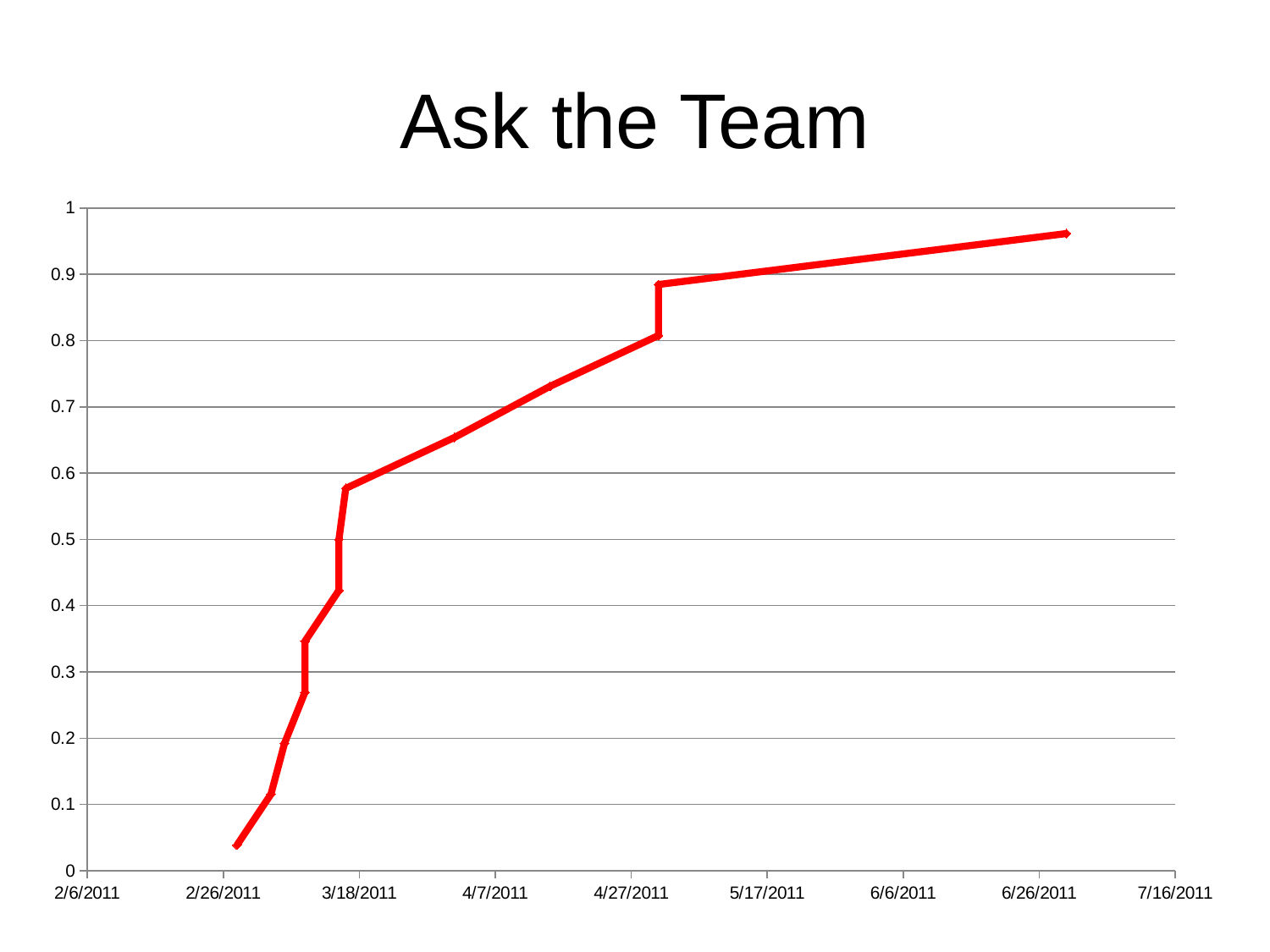
Which is larger, the value at the rightmost point or the value at the leftmost point? the rightmost point What kind of chart is shown on the slide? line chart What colour is the plotted line? red Is the value of the first (leftmost) point greater or less than 0.1? less How many lines (series) are plotted on the chart? 1 Do the values rise or fall as the dates move from left to right along the x axis? rise What is the title of the chart? Ask the Team Is the lowest value on the line greater or less than 0.1? less Is the value of the last (rightmost) point greater or less than 0.9? greater